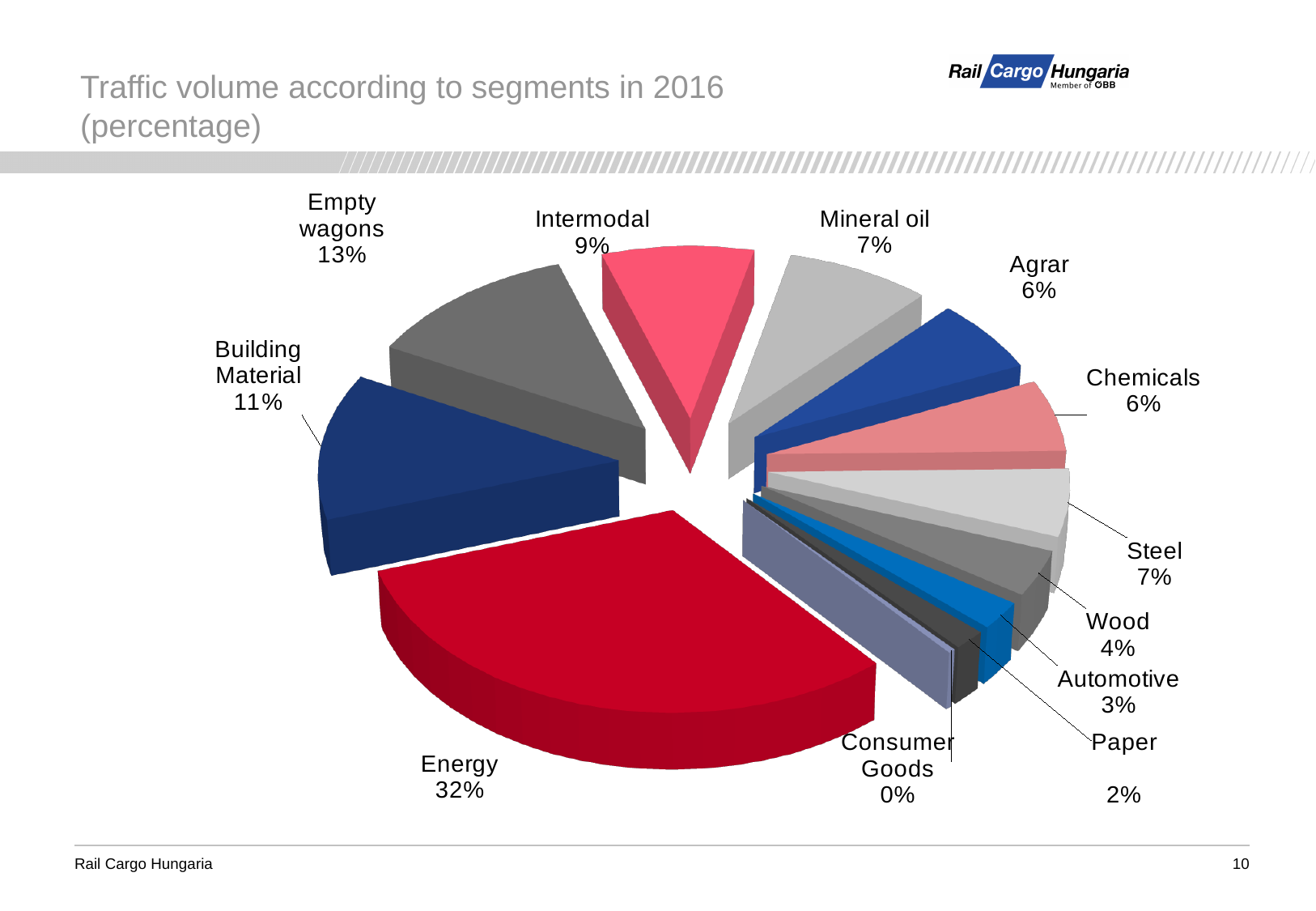
What is the title of the chart on the slide? Traffic volume according to segments in 2016 (percentage) How many segments are shown in the pie chart? 12 What is the value shown for Empty wagons? 13% Which has a larger share, Intermodal or Mineral oil? Intermodal What is the share of Energy in the pie chart? 32% What kind of chart is shown on the slide? Pie chart Which segment has the largest share of traffic volume? Energy What is the difference in percentage points between Energy and Empty wagons? 19 What percentage does Building Material account for? 11% What is the combined share of Steel and Wood? 11% Which segment has the smallest share of traffic volume? Consumer Goods What share is shown for Automotive? 3%